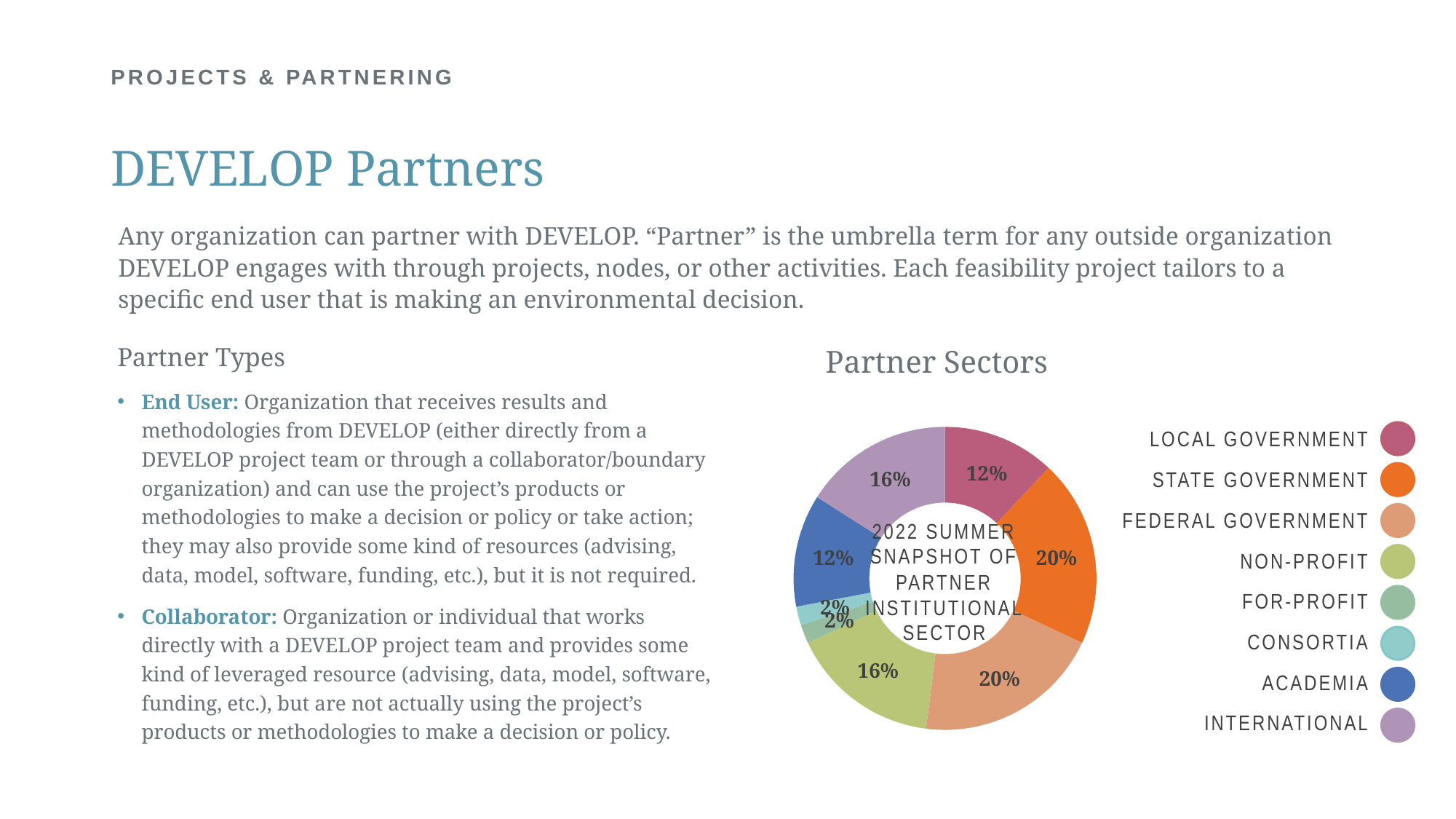
What type of chart is the Partner Sectors chart? Doughnut chart What is the difference in percentage points between State Government and Local Government in the Partner Sectors chart? 8 In the Partner Sectors chart, which is larger: For-Profit or Academia? Academia What share of the Partner Sectors chart is State Government? 20% What is the difference in percentage points between International and Consortia in the Partner Sectors chart? 14 What percentage does Academia account for in the Partner Sectors chart? 12% What percentage is shown for Consortia in the Partner Sectors chart? 2% What text appears in the centre of the Partner Sectors chart? 2022 SUMMER SNAPSHOT OF PARTNER INSTITUTIONAL SECTOR In the Partner Sectors chart, which is larger: Non-Profit or Local Government? Non-Profit What is the value for Federal Government in the Partner Sectors chart? 20% How many sectors are shown in the Partner Sectors chart? 8 What is the value shown for International in the Partner Sectors chart? 16%